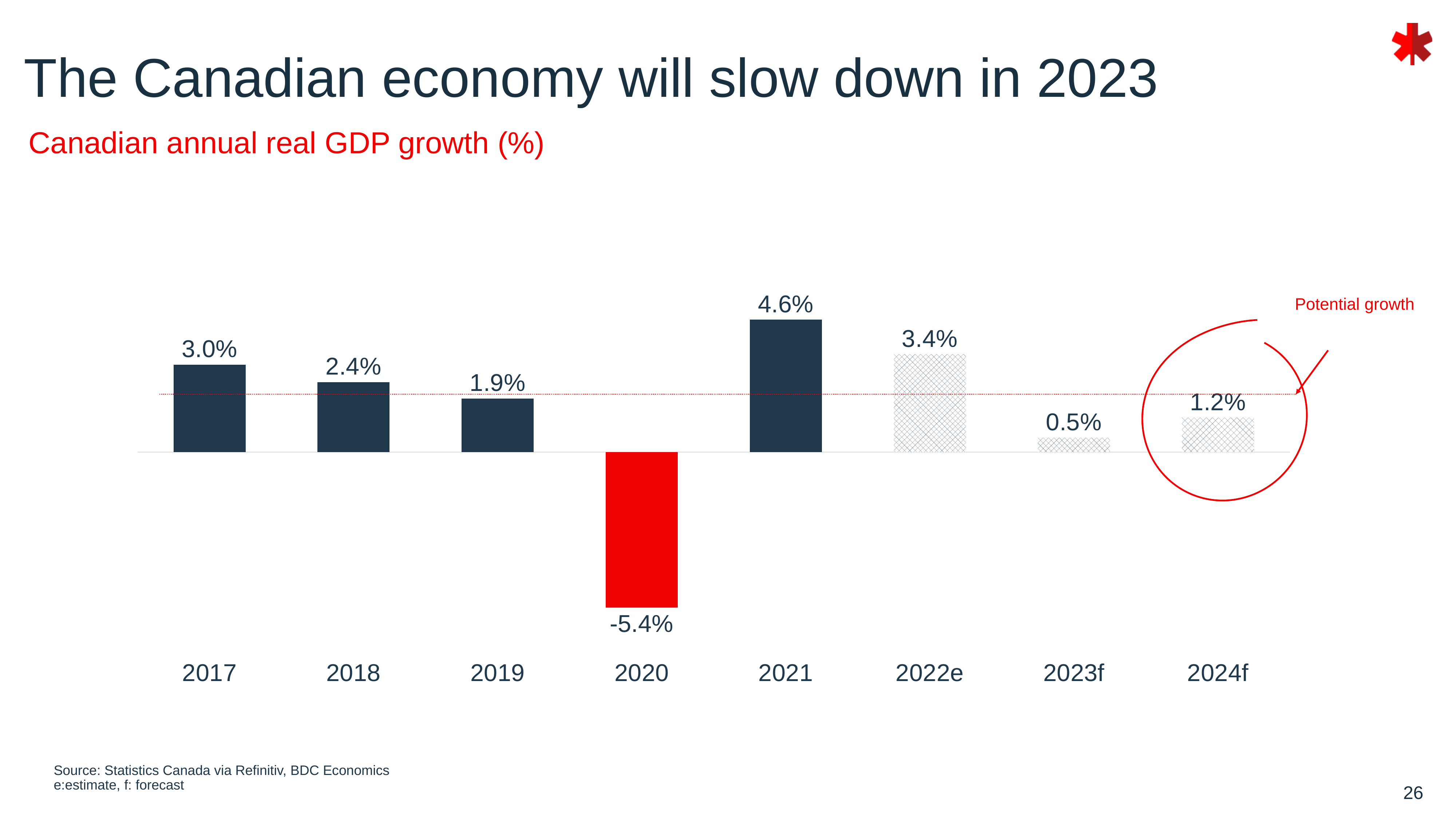
Which is larger, the GDP growth value for 2017 or for 2018? 2017 Do the GDP growth values rise or fall from 2017 to 2019? Fall What is the forecast GDP growth value for 2023f? 0.5% Which year has the highest GDP growth value on the chart? 2021 What kind of chart is shown on the slide? Bar chart Which year has the lowest GDP growth value on the chart? 2020 What does the red dotted horizontal line on the chart represent? Potential growth How many years are shown on the x axis of the chart? 8 What is the GDP growth value shown for 2020? -5.4% What is the Canadian annual real GDP growth value for 2021? 4.6% What is the difference between the GDP growth values for 2021 and 2022e? 1.2% What is the estimated GDP growth value for 2022e? 3.4%